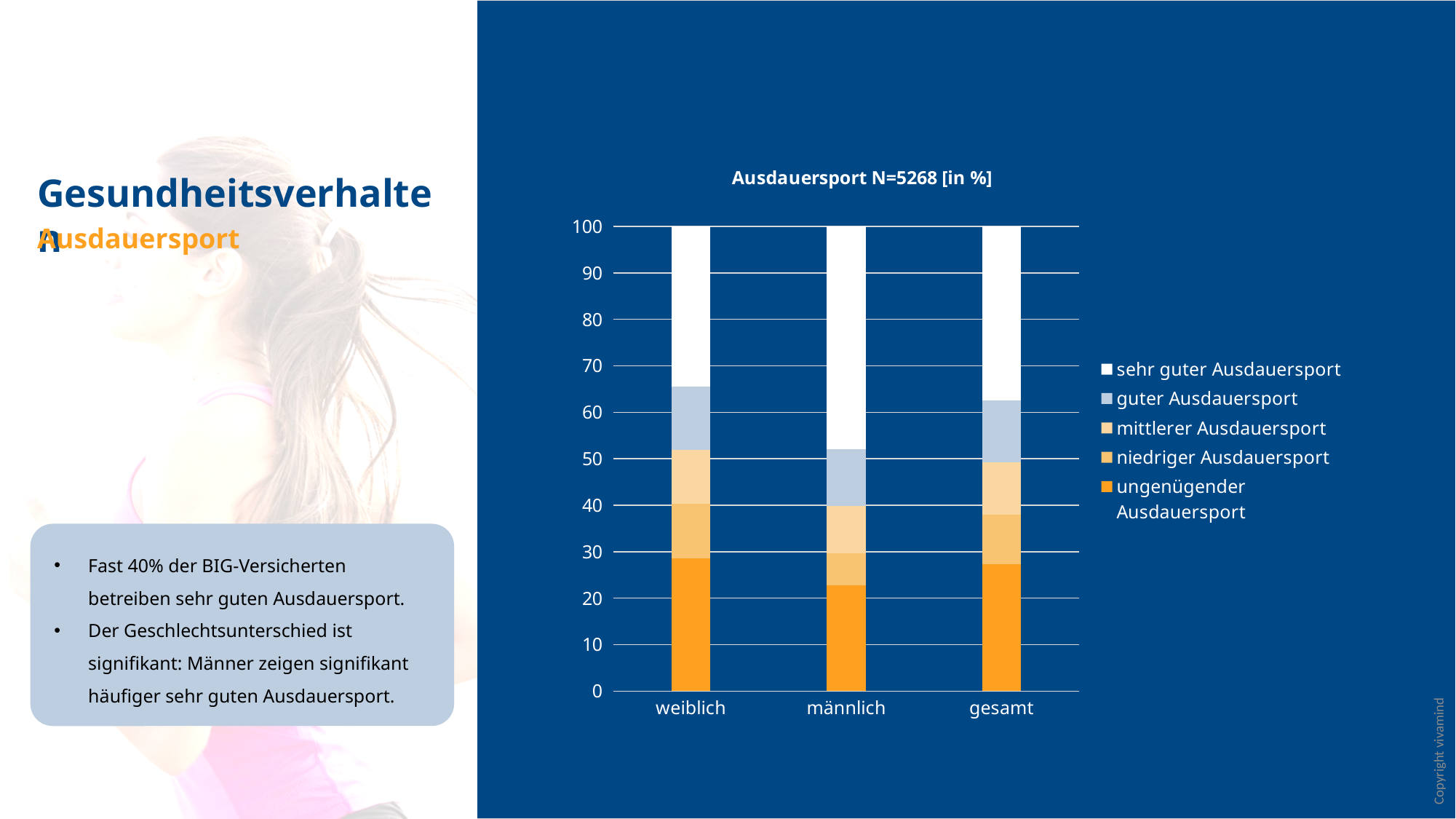
Is the 'ungenügender Ausdauersport' value for 'männlich' greater or less than 30? less Which category has the largest 'sehr guter Ausdauersport' segment? männlich How many series does the chart legend list? 5 Is the 'sehr guter Ausdauersport' value for 'männlich' greater or less than 40? greater What kind of chart is shown on the slide? Stacked bar chart Which colour represents 'sehr guter Ausdauersport' in the chart? White Which is larger, the 'ungenügender Ausdauersport' value for 'weiblich' or for 'männlich'? weiblich Is the 'ungenügender Ausdauersport' value for 'weiblich' greater or less than 20? greater What is the title of the chart? Ausdauersport N=5268 [in %] How many categories are shown on the x axis of the chart? 3 What is the total height of the stacked bar for 'weiblich'? 100